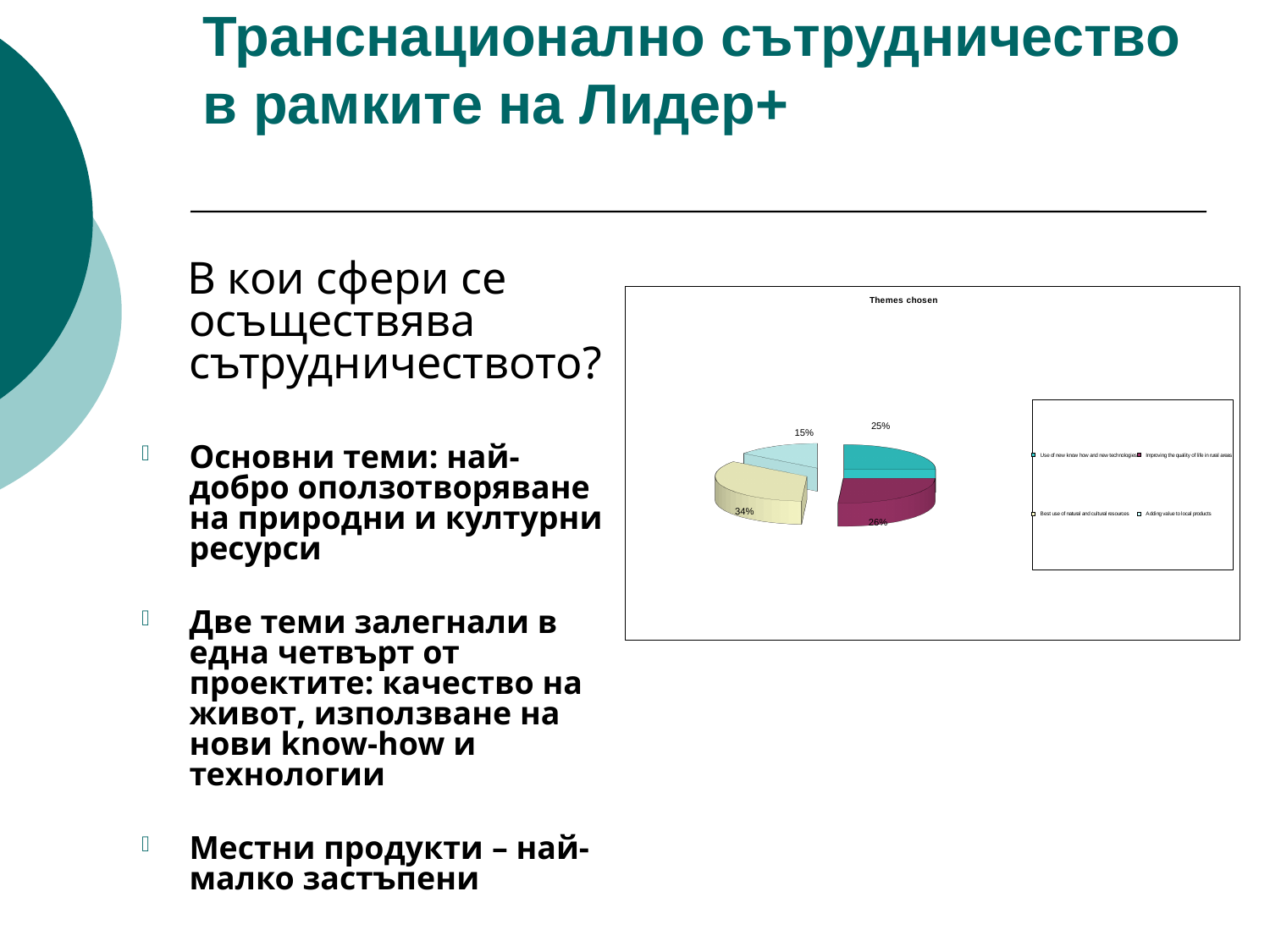
What type of chart is shown on the slide? pie chart What is the value of the largest slice in the pie chart? 34% How many slices does the pie chart have? 4 What is the value of the smallest slice in the pie chart? 15% What is the title of the chart? Themes chosen What is the difference between the largest slice (34%) and the smallest slice (15%)? 19 percentage points What do the four slice percentages (25%, 26%, 34%, 15%) add up to? 100% Which is larger, the slice labelled 25% or the slice labelled 26%? 26% What percentage is shown on the pale yellow slice of the pie chart? 34% What percentage is shown on the dark magenta slice of the pie chart? 26% What is the difference between the 34% slice and the 26% slice? 8 percentage points How many entries does the chart's legend list? 4